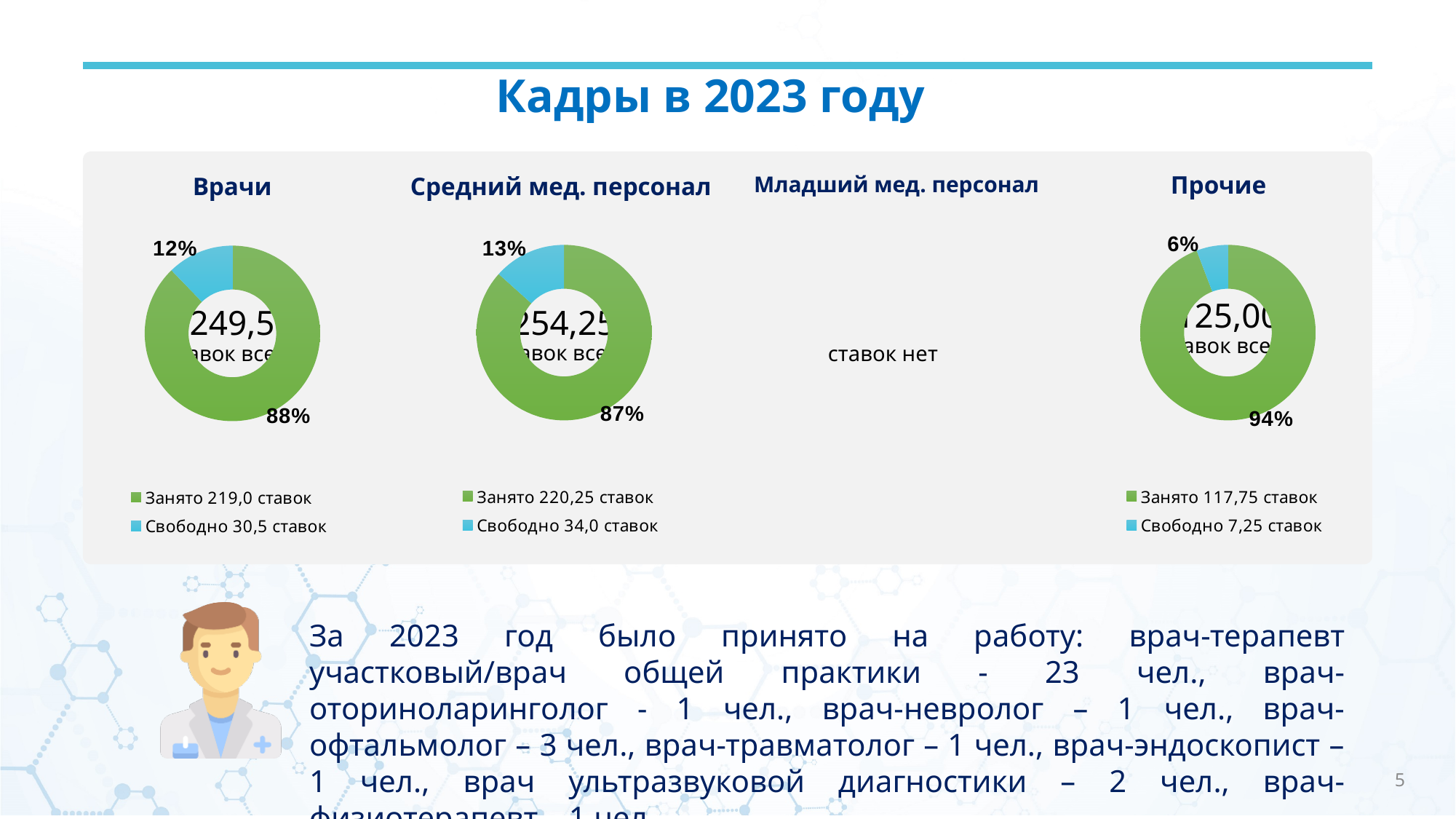
In the "Средний мед. персонал" chart, what percentage is shown for the "Свободно" slice? 13% In the "Прочие" chart, which slice is larger, "Занято" or "Свободно"? Занято Which of the three charts has the smallest "Свободно" share? Прочие In the "Средний мед. персонал" chart, how many ставок does the legend give for "Свободно"? 34,0 In the "Прочие" chart, what percentage is shown for the "Занято" slice? 94% In the "Прочие" chart, how many ставок does the legend give for "Свободно"? 7,25 In the "Врачи" chart, how many ставок does the legend give for "Занято"? 219,0 How many entries does the legend of the "Средний мед. персонал" chart list? 2 What kind of chart is used for "Врачи"? Donut (pie) chart In the "Врачи" chart, what percentage of positions is shown for the "Занято" slice? 88% In the "Средний мед. персонал" chart, what is the difference in percentage points between the "Занято" and "Свободно" slices? 74 In the "Врачи" chart, what percentage is shown for the "Свободно" slice? 12%